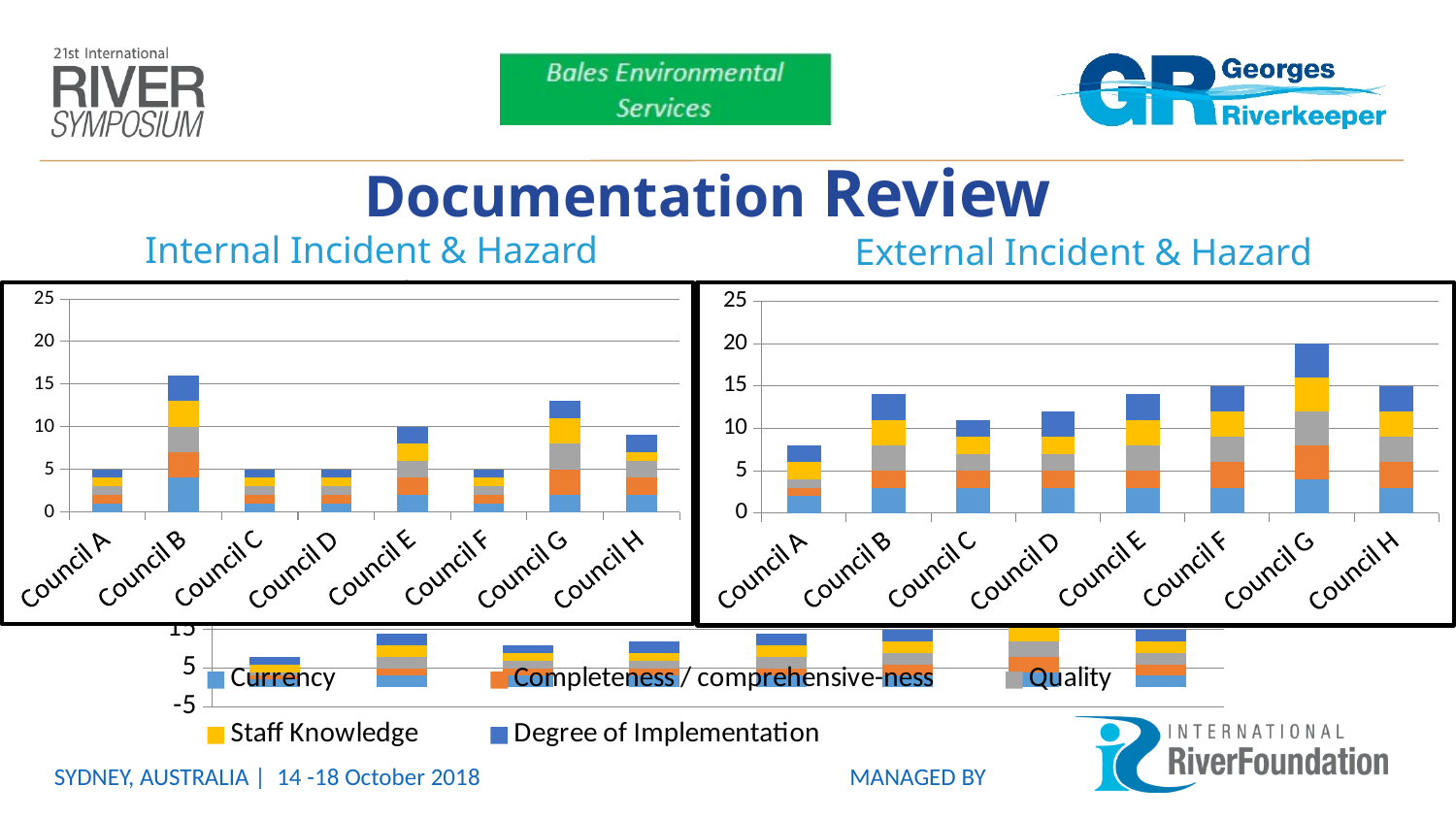
How many series does the legend at the bottom of the slide list? 5 According to the legend, which series is shown in yellow? Staff Knowledge In the External Incident & Hazard chart, is the total for Council A greater or less than 10? less In the Internal Incident & Hazard chart, is the total for Council B greater or less than 15? greater In the Internal Incident & Hazard chart, is the total for Council G greater or less than 10? greater In the Internal Incident & Hazard chart, which council has the tallest stacked bar? Council B How many councils are shown on the x axis of the External Incident & Hazard chart? 8 What kind of chart is the Internal Incident & Hazard chart? Stacked bar chart In the External Incident & Hazard chart, which council has the tallest stacked bar? Council G In the Internal Incident & Hazard chart, which has the larger total, Council B or Council E? Council B In the External Incident & Hazard chart, which council has the shortest stacked bar? Council A